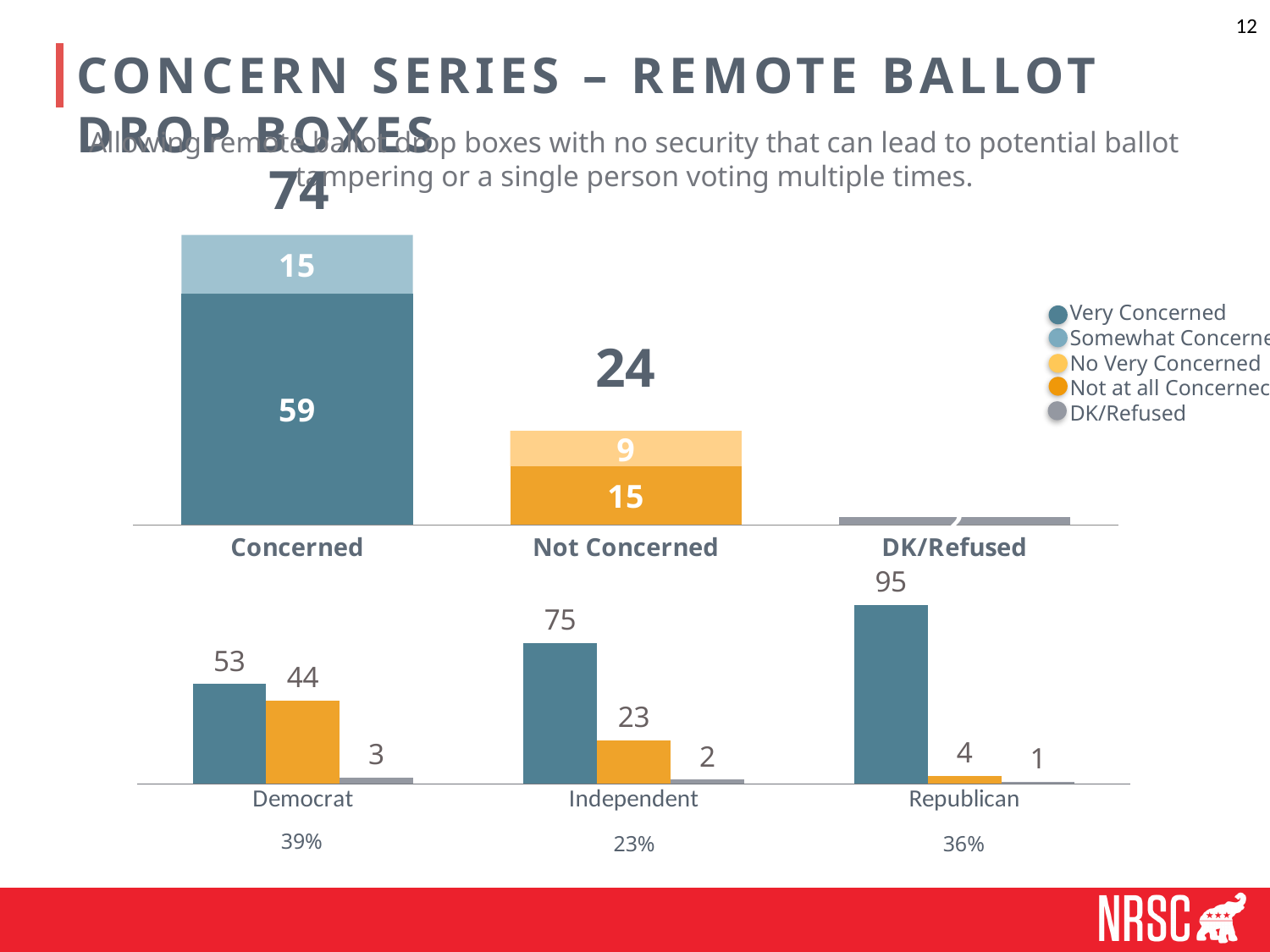
In the top stacked bar chart, what is the total for the Concerned bar? 74 In the top stacked bar chart, what is the value of the dark blue (Very Concerned) segment of the Concerned bar? 59 In the top stacked bar chart, what is the value of the dark orange (Not at all Concerned) segment of the Not Concerned bar? 15 How many entries does the legend on the top chart list? 5 In the bottom chart, what is the value of the blue bar for Republican? 95 In the bottom chart, which party group has the highest blue bar? Republican In the top stacked bar chart, what is the total for the Not Concerned bar? 24 In the bottom chart, what is the difference between the blue bar and the orange bar for Independent? 52 In the top stacked bar chart, what is the difference between the Concerned total and the Not Concerned total? 50 In the bottom chart, which party group has the lowest gray bar? Republican In the bottom chart, what is the value of the orange bar for Democrat? 44 In the top stacked bar chart, what is the value of the light blue (Somewhat Concerned) segment of the Concerned bar? 15